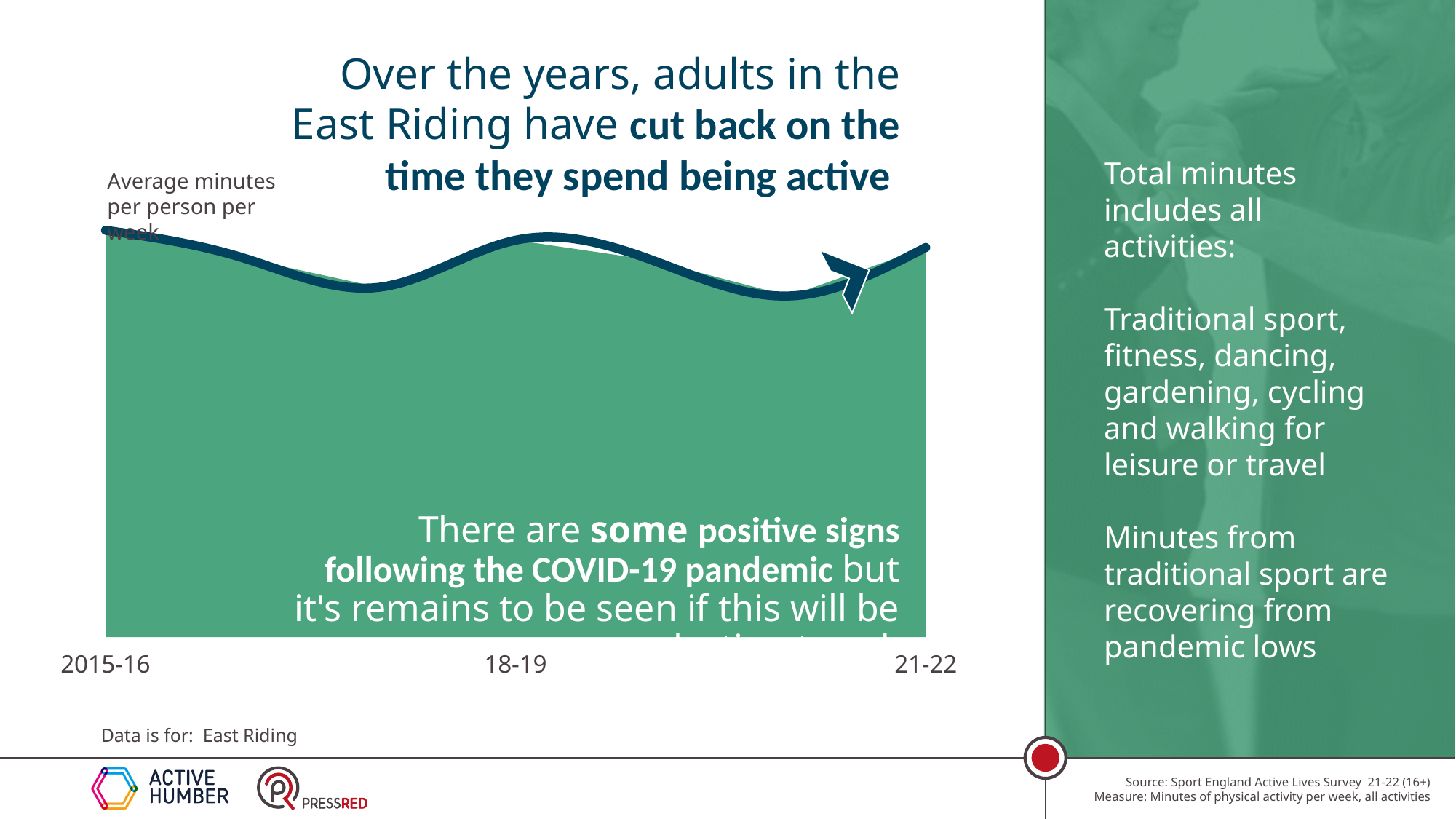
What is the first year label on the x axis of the chart? 2015-16 How many data series are plotted in the chart? 2 What is the last year label on the x axis of the chart? 21-22 What kind of chart is shown on the slide? Area and line chart Do the values in the chart rise or fall between 18-19 and the low point before 21-22? Fall Overall, do the values in the chart rise or fall from 2015-16 to 21-22? Fall Which is higher in the chart, the value for 2015-16 or the value for 21-22? 2015-16 How many year labels are shown along the x axis of the chart? 3